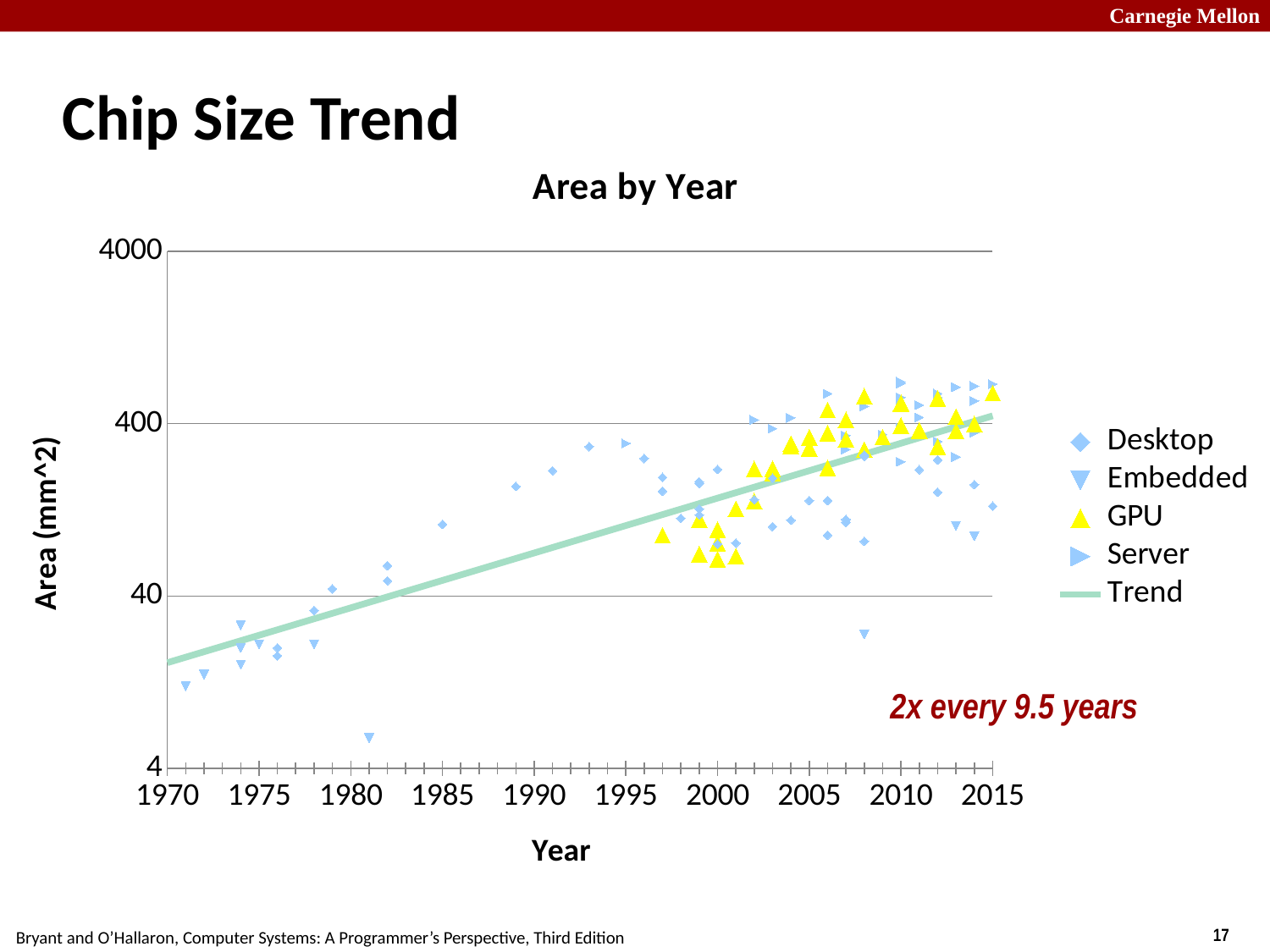
Are the GPU points around 2000 greater or less than 400? less Is the value of the Embedded point near 2008 greater or less than 40? less Is the value of the Desktop point near 1985 greater or less than 40? greater What is the title of the chart? Area by Year How many series does the legend list? 5 What kind of chart is shown on the slide? scatter chart What is the label of the vertical axis? Area (mm^2) Does the Trend line rise or fall as the year increases? rise